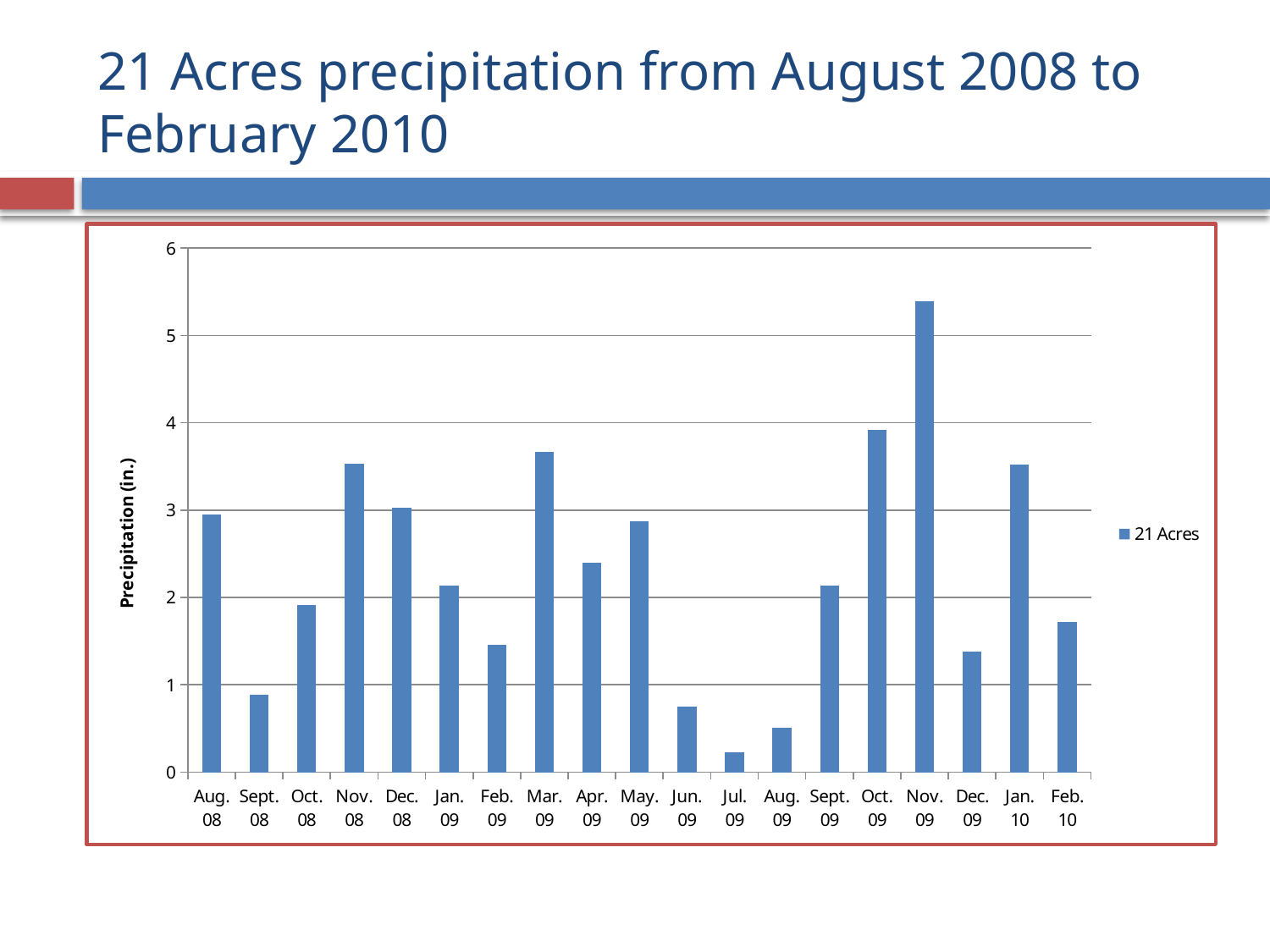
Is the precipitation for Nov. 09 greater or less than 5? greater Which has higher precipitation, Mar. 09 or Apr. 09? Mar. 09 What is the label of the vertical axis? Precipitation (in.) How many months (bars) are plotted on the chart? 19 Which has higher precipitation, Oct. 09 or Sept. 09? Oct. 09 What kind of chart is shown on the slide? bar chart Is the precipitation for Nov. 08 greater or less than 3? greater How many series does the legend list? 1 Is the precipitation for Jul. 09 greater or less than 1? less Which month has the highest precipitation? Nov. 09 Which month has the lowest precipitation? Jul. 09